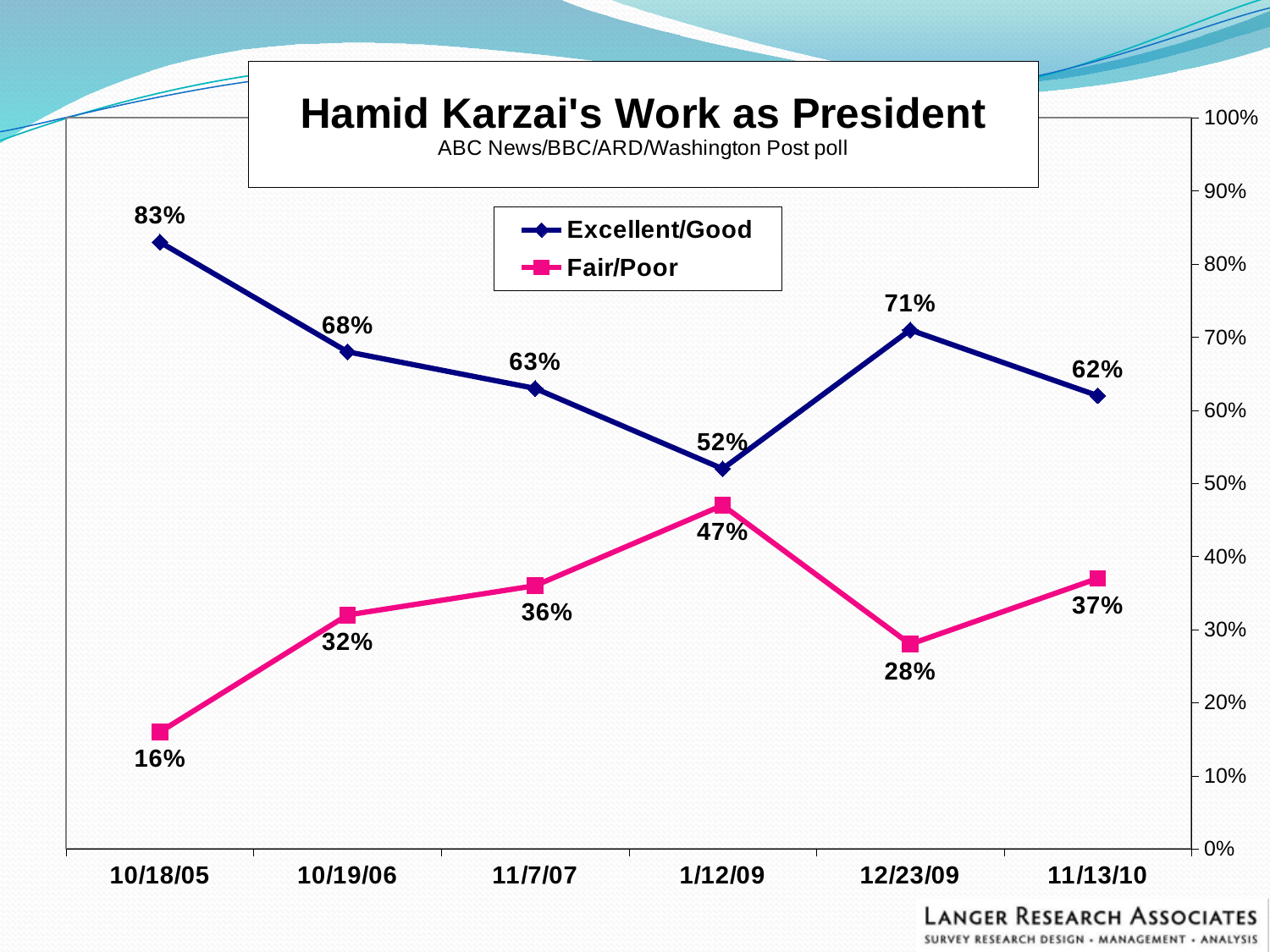
What is the Excellent/Good value on 12/23/09? 71% What is the Fair/Poor value on 1/12/09? 47% Which is larger on 11/7/07, Excellent/Good or Fair/Poor? Excellent/Good What is the difference between the Excellent/Good and Fair/Poor values on 11/13/10? 25% How many series does the legend list? 2 On which date is the Excellent/Good value lowest? 1/12/09 What kind of chart is this? Line chart Does the Fair/Poor value rise or fall from 10/18/05 to 1/12/09? Rise What is the title of the chart? Hamid Karzai's Work as President On which date is the Fair/Poor value lowest? 10/18/05 What is the Excellent/Good value on 10/18/05? 83% How many dates are plotted on the x axis? 6